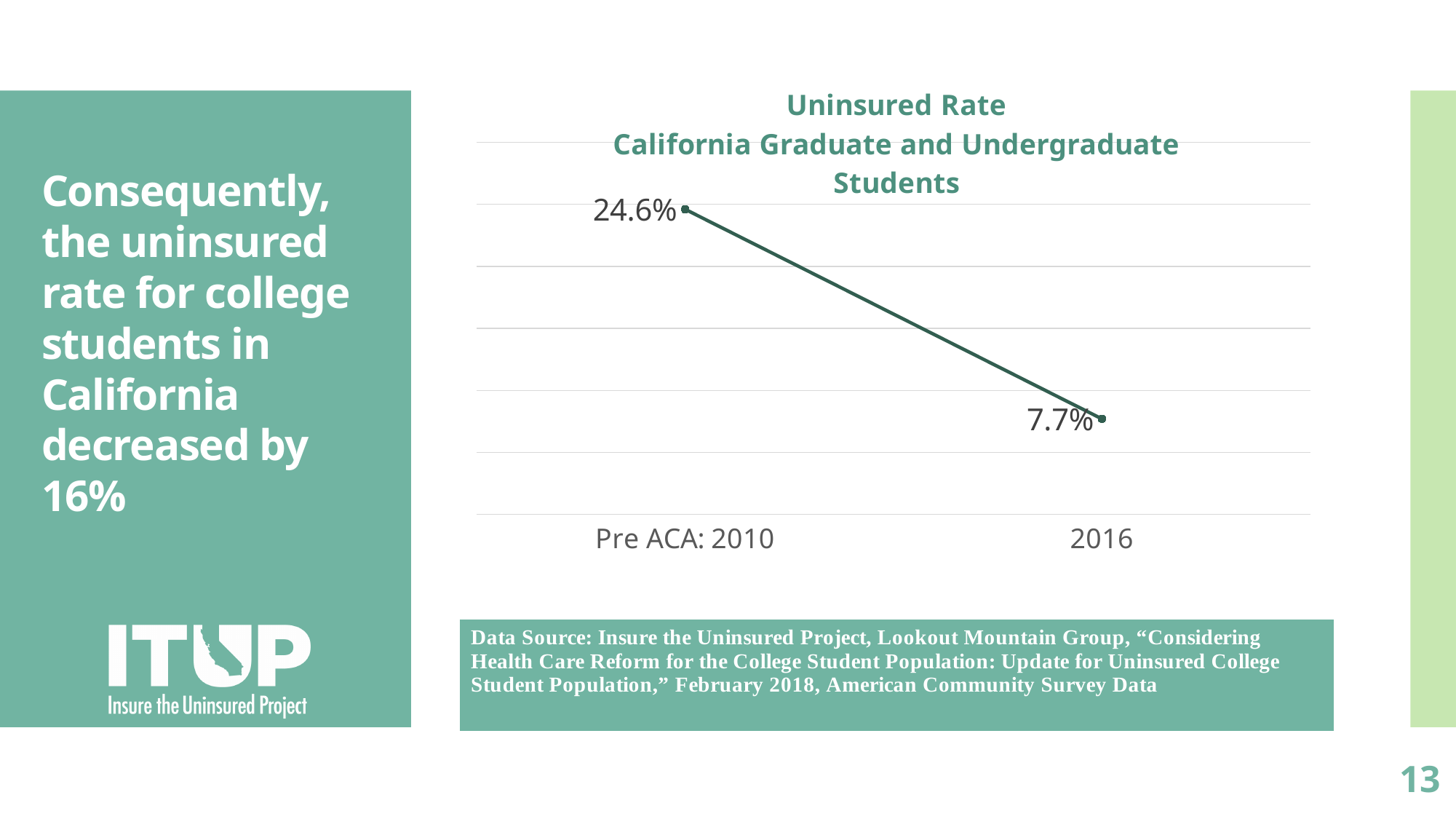
What is the label of the first point on the x axis? Pre ACA: 2010 What is the difference between the uninsured rate in Pre ACA: 2010 and in 2016? 16.9% What is the title of the chart? Uninsured Rate California Graduate and Undergraduate Students How many data points are plotted on the chart? 2 What is the uninsured rate for 2016? 7.7% Which is larger, the uninsured rate for Pre ACA: 2010 or for 2016? Pre ACA: 2010 Which point has the lowest uninsured rate? 2016 Does the uninsured rate rise or fall from Pre ACA: 2010 to 2016? Fall What kind of chart is shown on the slide? Line chart What is the uninsured rate for Pre ACA: 2010? 24.6% Which point has the highest uninsured rate? Pre ACA: 2010